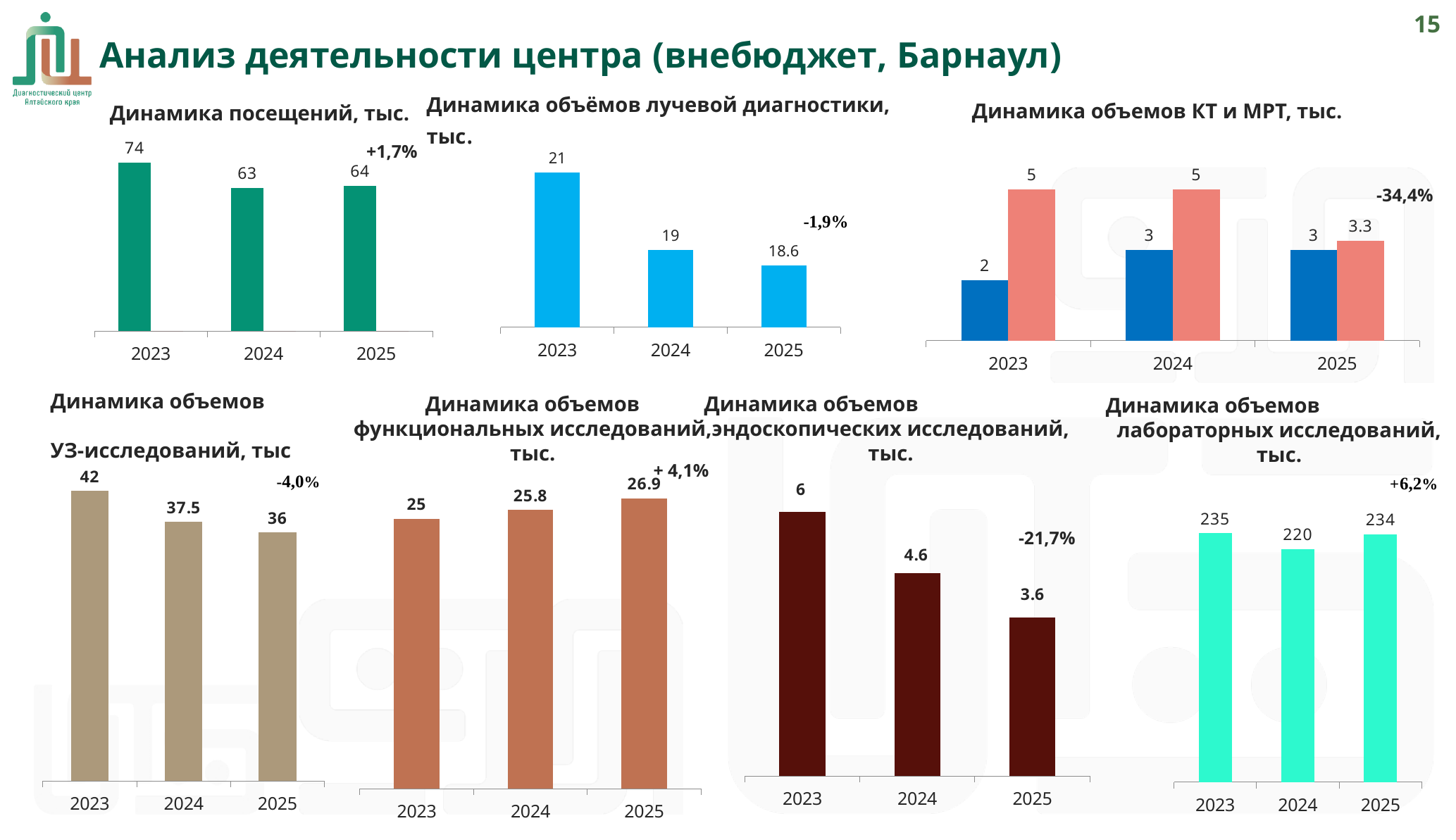
In the chart 'Динамика объемов УЗ-исследований, тыс', which year has the highest value? 2023 In the chart 'Динамика посещений, тыс.', what is the value for 2023? 74 In the chart 'Динамика объемов КТ и МРТ, тыс.', how many bars are shown for each year? 2 In the chart 'Динамика объёмов лучевой диагностики, тыс.', do the values rise or fall from 2023 to 2025? fall In the chart 'Динамика объёмов лучевой диагностики, тыс.', what is the value for 2025? 18.6 In the chart 'Динамика объемов УЗ-исследований, тыс', what is the value for 2024? 37.5 In the chart 'Динамика объемов КТ и МРТ, тыс.', what is the value of the pink bar for 2025? 3.3 In the chart 'Динамика посещений, тыс.', what is the difference between the 2023 and 2024 values? 11 What type of chart is 'Динамика объемов лабораторных исследований, тыс.'? bar chart In the chart 'Динамика объемов функциональных исследований, тыс.', which is larger: the value for 2024 or 2025? 2025 In the chart 'Динамика объемов эндоскопических исследований, тыс.', which year has the lowest value? 2025 In the chart 'Динамика объемов лабораторных исследований, тыс.', what is the difference between the 2023 and 2024 values? 15